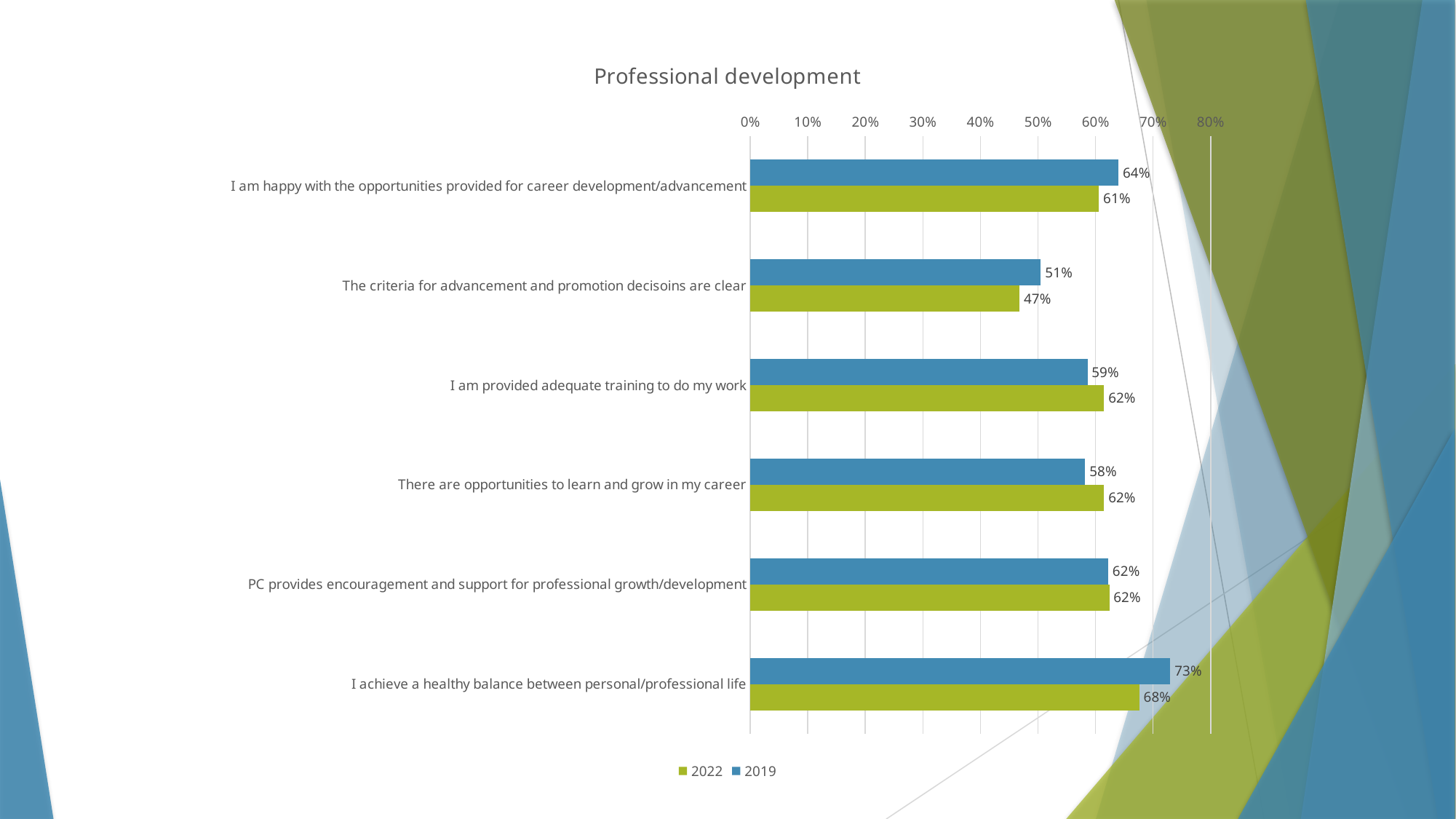
How many series does the legend list? 2 What is the 2022 value for "I am provided adequate training to do my work"? 62% For "There are opportunities to learn and grow in my career", which year has the larger value, 2019 or 2022? 2022 Which category has the highest 2019 value? I achieve a healthy balance between personal/professional life What is the title of the chart? Professional development How many categories are shown on the chart? 6 What kind of chart is shown on the slide? Bar chart What is the difference between the 2019 and 2022 values for "I achieve a healthy balance between personal/professional life"? 5% What is the 2019 value for "I achieve a healthy balance between personal/professional life"? 73% Is the 2019 value for "I am happy with the opportunities provided for career development/advancement" greater or less than 50%? greater Which category has the lowest 2022 value? The criteria for advancement and promotion decisoins are clear What is the 2022 value for "The criteria for advancement and promotion decisoins are clear"? 47%